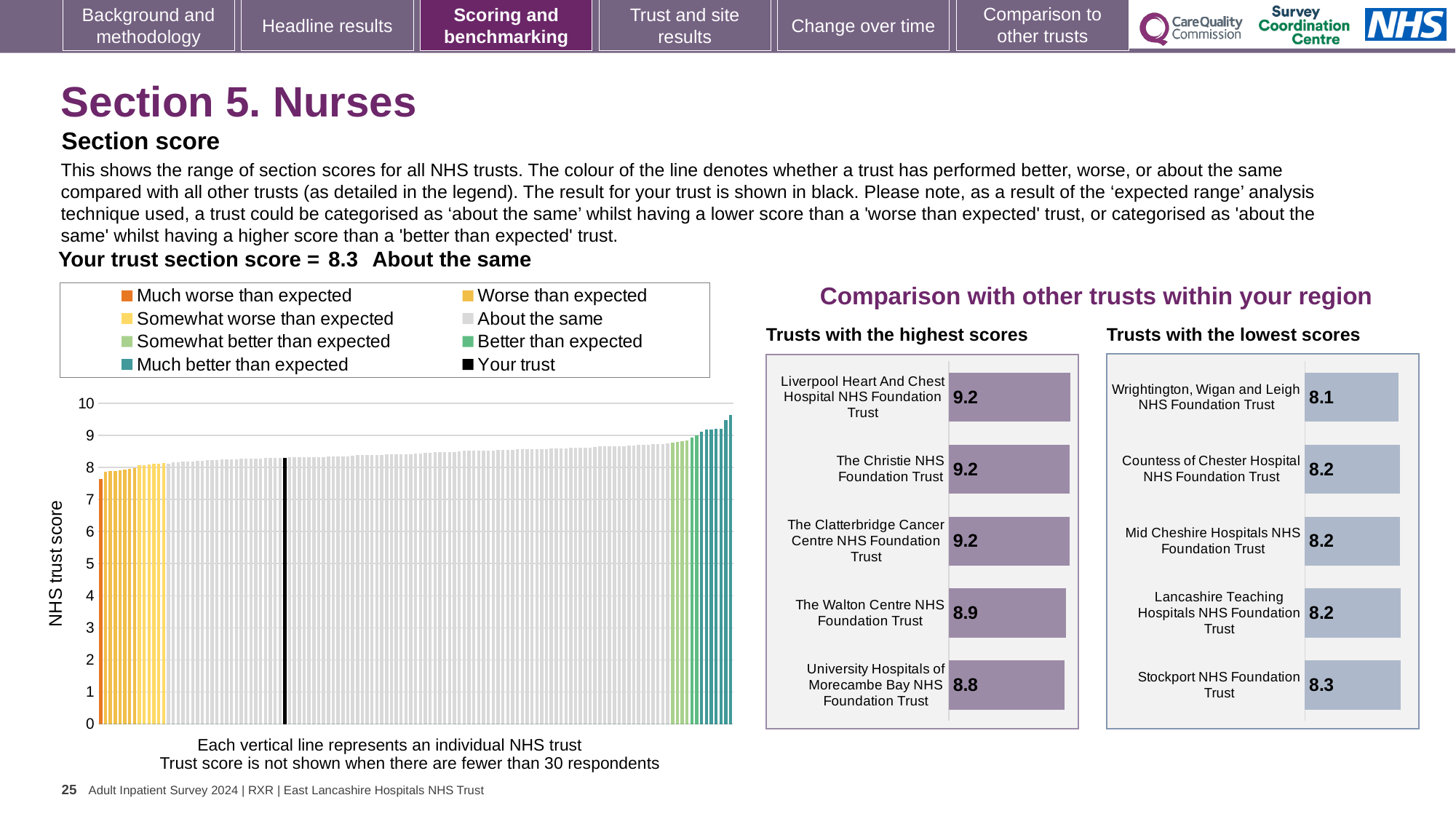
In the large chart on the left showing NHS trust scores, is the value of the leftmost (lowest) bar greater or less than 8? less How many entries does the legend of the large chart on the left list? 8 In the 'Trusts with the lowest scores' chart, which trust has the highest score? Stockport NHS Foundation Trust In the 'Trusts with the highest scores' chart, which trust has the lowest score? University Hospitals of Morecambe Bay NHS Foundation Trust In the 'Trusts with the highest scores' chart, what is the score for The Walton Centre NHS Foundation Trust? 8.9 In the 'Trusts with the lowest scores' chart, what is the score for Wrightington, Wigan and Leigh NHS Foundation Trust? 8.1 In the 'Trusts with the highest scores' chart, what is the score for University Hospitals of Morecambe Bay NHS Foundation Trust? 8.8 In the 'Trusts with the highest scores' chart, what is the difference between the score for Liverpool Heart And Chest Hospital NHS Foundation Trust and the score for University Hospitals of Morecambe Bay NHS Foundation Trust? 0.4 In the 'Trusts with the lowest scores' chart, what is the difference between the score for Stockport NHS Foundation Trust and the score for Wrightington, Wigan and Leigh NHS Foundation Trust? 0.2 In the large chart on the left showing NHS trust scores, do the values rise or fall from left to right along the x axis? rise In the 'Trusts with the highest scores' chart, which has the larger score: The Walton Centre NHS Foundation Trust or University Hospitals of Morecambe Bay NHS Foundation Trust? The Walton Centre NHS Foundation Trust How many trusts are listed in the 'Trusts with the lowest scores' chart? 5